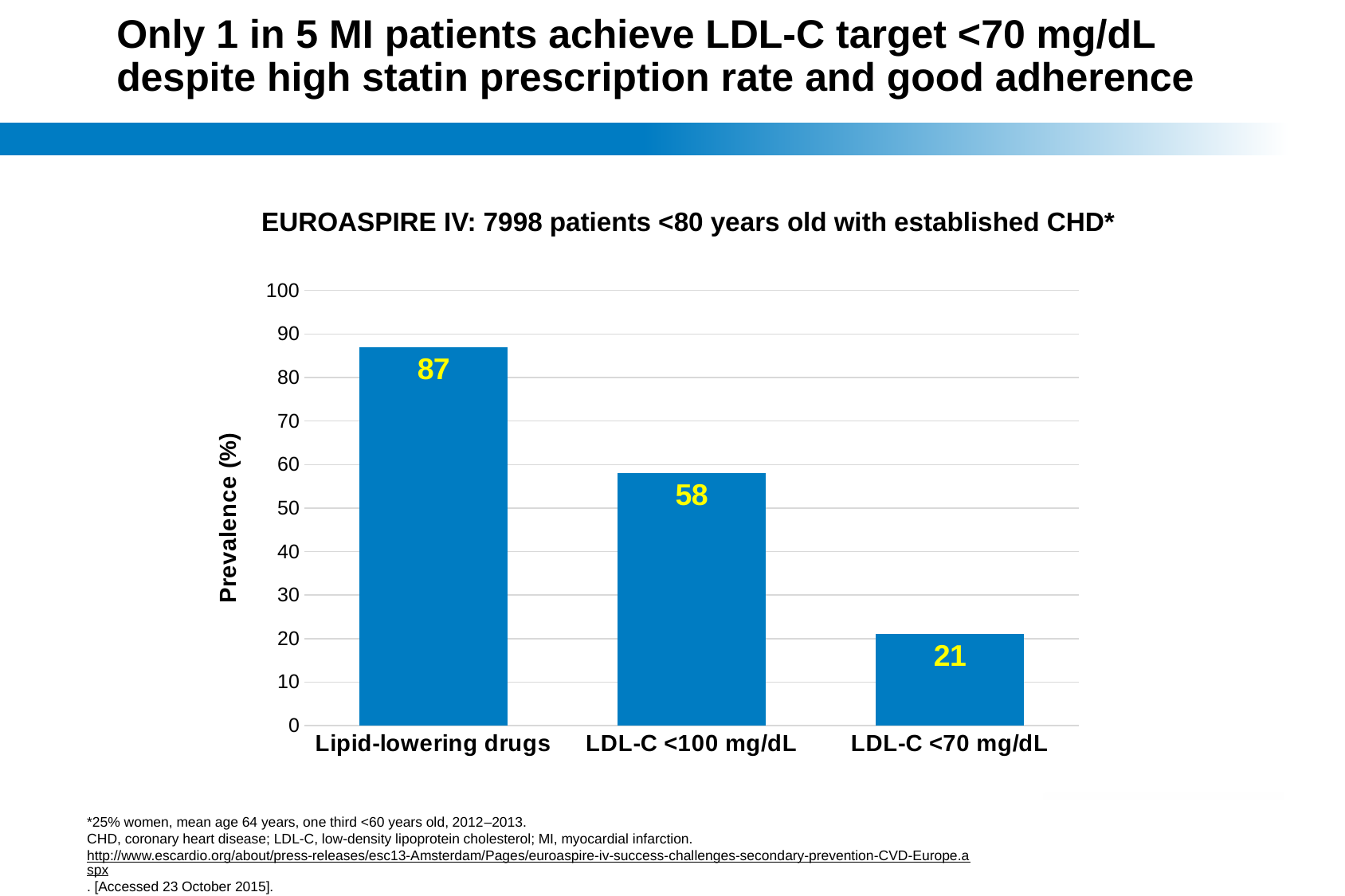
Which category has the highest prevalence? Lipid-lowering drugs What is the prevalence value for Lipid-lowering drugs? 87 What is the label of the y axis? Prevalence (%) How many categories are shown on the x axis? 3 What kind of chart is shown on the slide? Bar chart What is the prevalence value for LDL-C <100 mg/dL? 58 What is the difference between the values for Lipid-lowering drugs and LDL-C <70 mg/dL? 66 Is the value for LDL-C <100 mg/dL greater or less than 50? greater Which is larger, the value for LDL-C <100 mg/dL or the value for LDL-C <70 mg/dL? LDL-C <100 mg/dL What is the prevalence value for LDL-C <70 mg/dL? 21 Which category has the lowest prevalence? LDL-C <70 mg/dL What is the difference between the values for LDL-C <100 mg/dL and LDL-C <70 mg/dL? 37